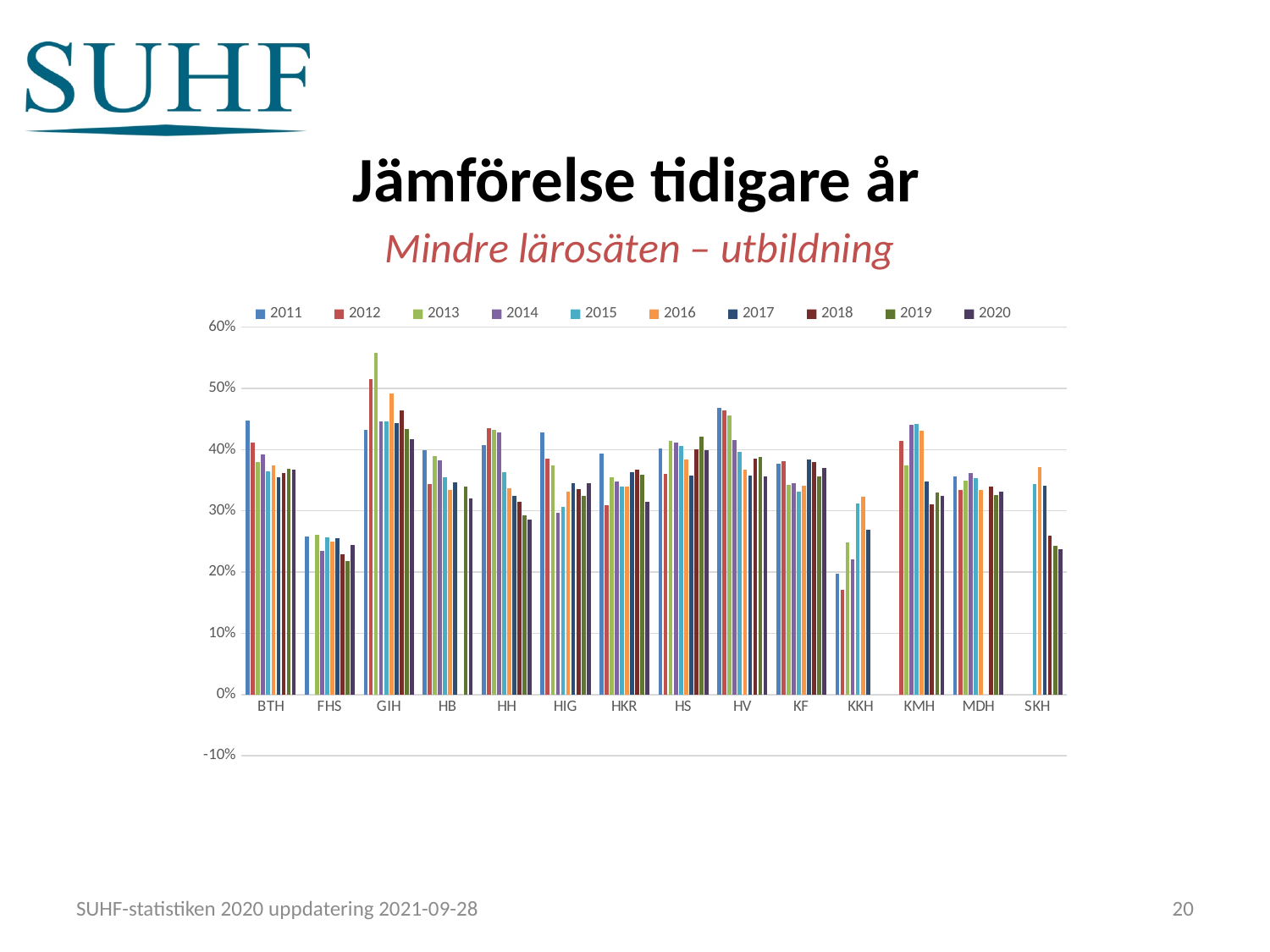
Is the 2013 value for GIH greater or less than 50%? greater How many series does the legend list? 10 For GIH, which year has the highest value? 2013 What kind of chart is shown on the slide? bar chart How many institutions (categories) are shown on the x axis? 14 Is the 2016 value for SKH greater or less than 30%? greater Which institution has the lowest 2011 value? KKH Is the 2012 value for KKH greater or less than 20%? less What is the subtitle shown above the chart? Mindre lärosäten – utbildning Which institution has the single tallest bar in the chart? GIH Which is larger, the 2013 value for GIH or the 2013 value for HB? GIH